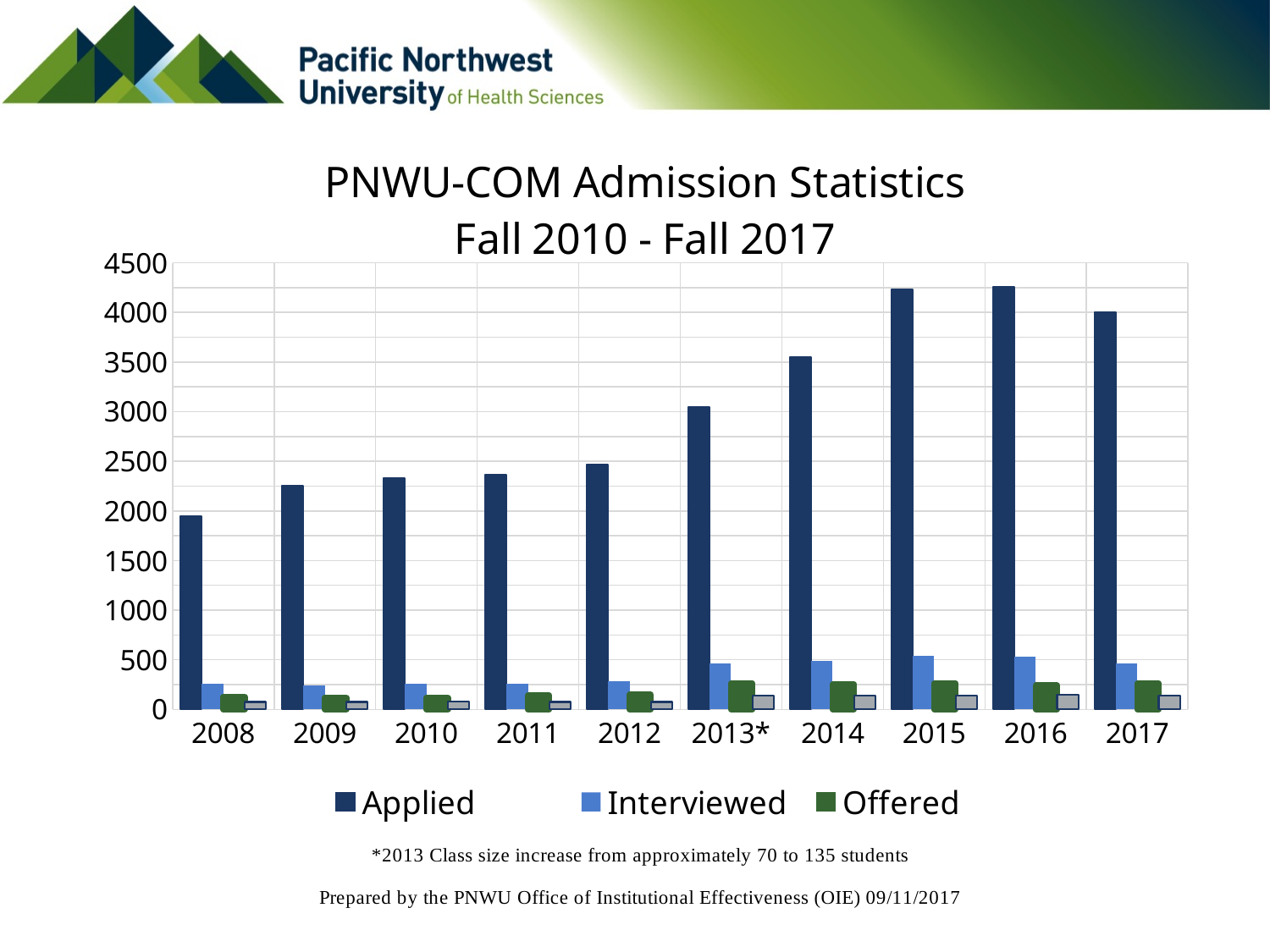
What kind of chart is shown on the slide? bar chart Does the Applied series generally rise or fall from 2008 to 2016? rise Which is larger, the Applied value for 2014 or for 2013*? 2014 How many series does the legend list? 3 Is the Interviewed value for 2008 greater or less than 500? less Which year has the lowest Applied value? 2008 Which is larger, the Applied value for 2017 or for 2012? 2017 Is the Applied value for 2015 greater or less than 4000? greater Is the Applied value for 2017 greater or less than 3500? greater How many years are shown on the x axis? 10 What is the title of the chart? PNWU-COM Admission Statistics Fall 2010 - Fall 2017